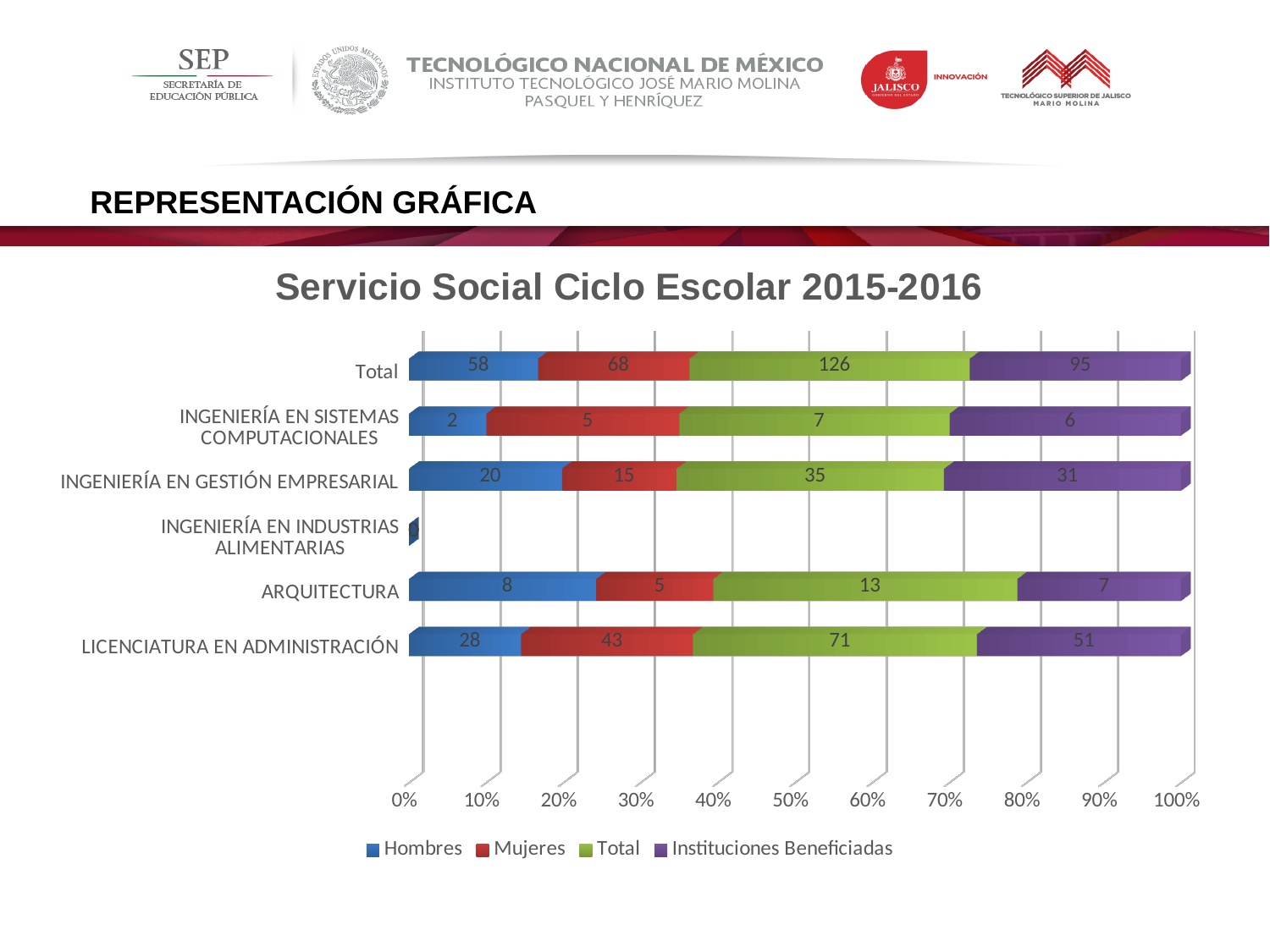
What is the Mujeres value for INGENIERÍA EN GESTIÓN EMPRESARIAL? 15 What is the Instituciones Beneficiadas value for ARQUITECTURA? 7 Which has a larger Hombres value, ARQUITECTURA or INGENIERÍA EN GESTIÓN EMPRESARIAL? INGENIERÍA EN GESTIÓN EMPRESARIAL How many categories are shown on the vertical axis of the chart? 6 What is the Total value for INGENIERÍA EN SISTEMAS COMPUTACIONALES? 7 Excluding the Total bar, which category has the highest Instituciones Beneficiadas value? LICENCIATURA EN ADMINISTRACIÓN How many series does the legend list? 4 What is the Mujeres value in the Total bar? 68 Excluding the Total bar, which category has the lowest Hombres value among those with printed labels? INGENIERÍA EN SISTEMAS COMPUTACIONALES What is the Hombres value for LICENCIATURA EN ADMINISTRACIÓN? 28 What is the difference between the Mujeres and Hombres values for LICENCIATURA EN ADMINISTRACIÓN? 15 What is the title of the chart? Servicio Social Ciclo Escolar 2015-2016